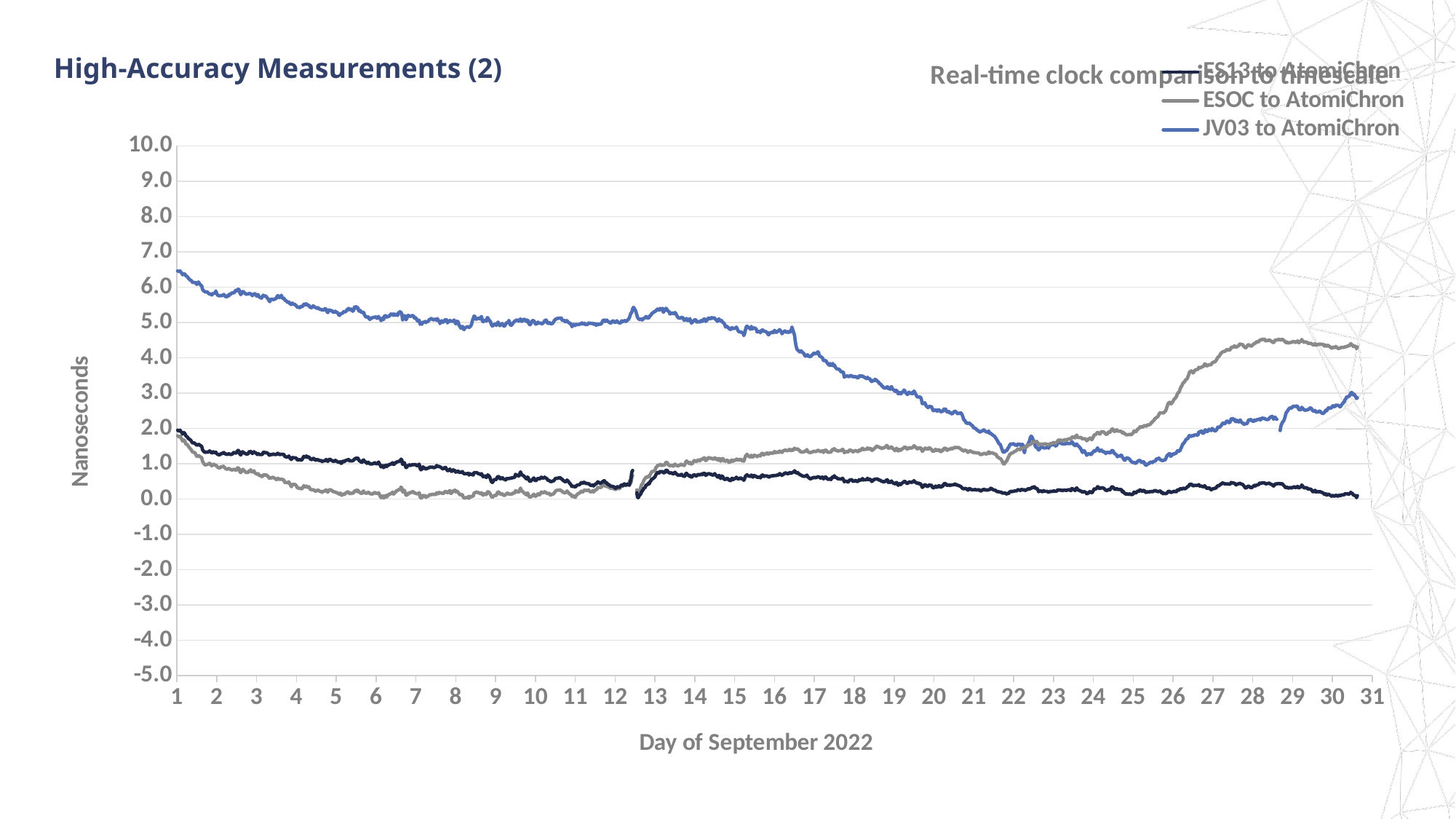
What kind of chart is shown on the slide? line chart Is the value for JV03 to AtomiChron on day 25 greater or less than 2.0? less What is the label on the vertical axis? Nanoseconds On day 30, which series has the higher value, ESOC to AtomiChron or JV03 to AtomiChron? ESOC to AtomiChron Does the ESOC to AtomiChron series rise or fall between day 25 and day 28? rise Is the value for JV03 to AtomiChron on day 1 greater or less than 5.0? greater Which series is drawn in blue? JV03 to AtomiChron On day 5, which series has the higher value, JV03 to AtomiChron or ES13 to AtomiChron? JV03 to AtomiChron Is the value for ESOC to AtomiChron on day 28 greater or less than 4.0? greater Does the JV03 to AtomiChron series rise or fall between day 17 and day 25? fall How many series does the legend list? 3